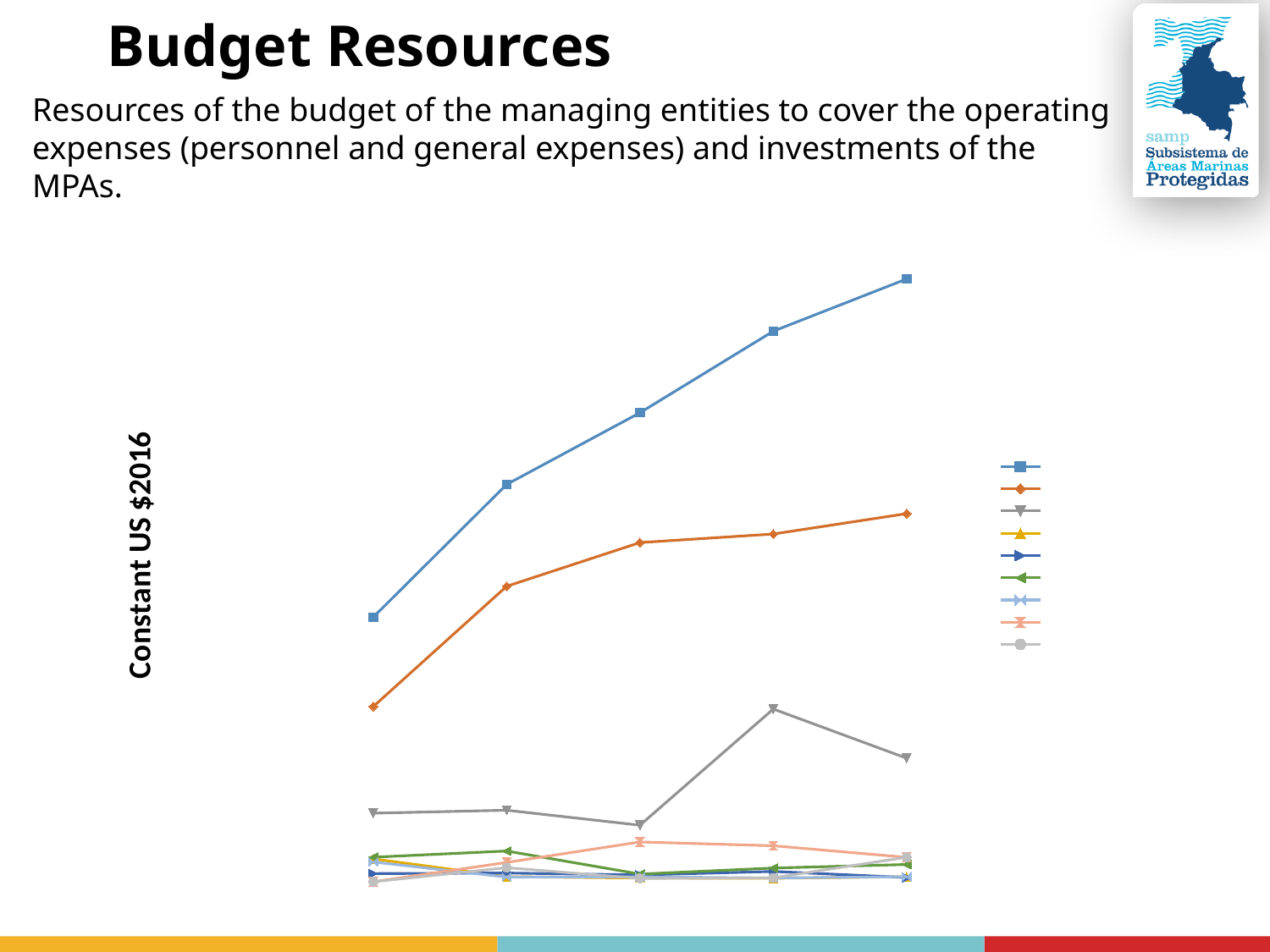
Does the topmost line (blue, square markers) rise or fall from left to right? rises What kind of chart is shown on the slide? line chart What is the title of the chart's vertical axis? Constant US $2016 How many data points does each line in the chart have? 5 How many series does the chart's legend list? 9 Does the second-highest line (orange, diamond markers) rise or fall from left to right? rises